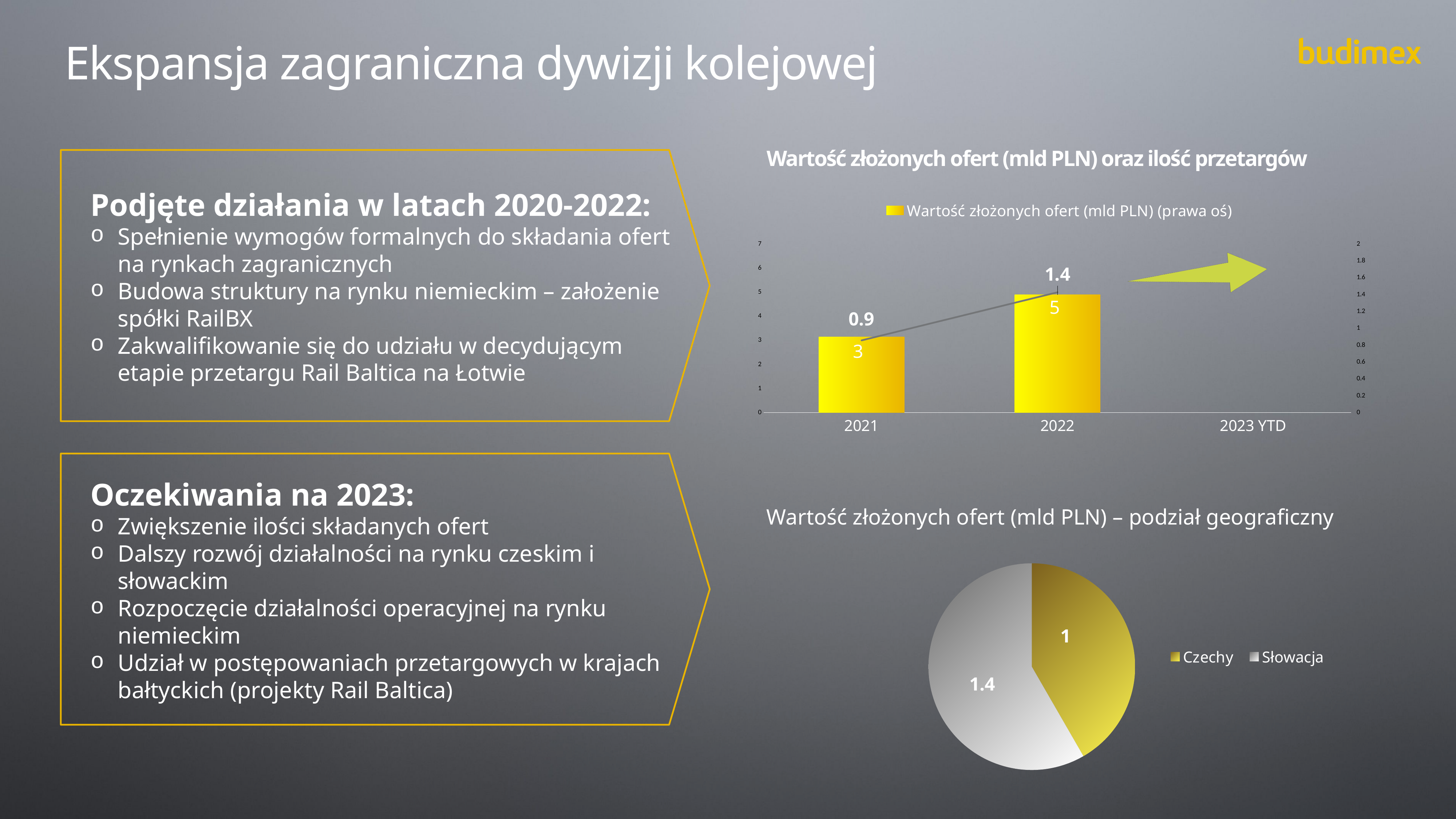
In the top chart, what is the single legend entry? Wartość złożonych ofert (mld PLN) (prawa oś) What kind of chart is the bottom chart 'Wartość złożonych ofert (mld PLN) – podział geograficzny'? pie chart In the top chart, do the values rise or fall from 2021 to 2022? rise In the top chart, how many categories are shown on the x axis? 3 In the bottom chart 'Wartość złożonych ofert (mld PLN) – podział geograficzny', what is the value for Czechy? 1 In the top chart 'Wartość złożonych ofert (mld PLN) oraz ilość przetargów', what is the value labelled on the bar for 2022? 5 In the top chart, what is the value of 'Wartość złożonych ofert (mld PLN)' for 2022? 1.4 In the top chart, what is the value of 'Wartość złożonych ofert (mld PLN)' for 2021? 0.9 In the bottom chart 'Wartość złożonych ofert (mld PLN) – podział geograficzny', what is the value for Słowacja? 1.4 In the top chart, what is the difference between the bar values for 2022 and 2021? 2 In the top chart, by how much did 'Wartość złożonych ofert (mld PLN)' increase from 2021 to 2022? 0.5 In the top chart 'Wartość złożonych ofert (mld PLN) oraz ilość przetargów', what is the value labelled on the bar for 2021? 3